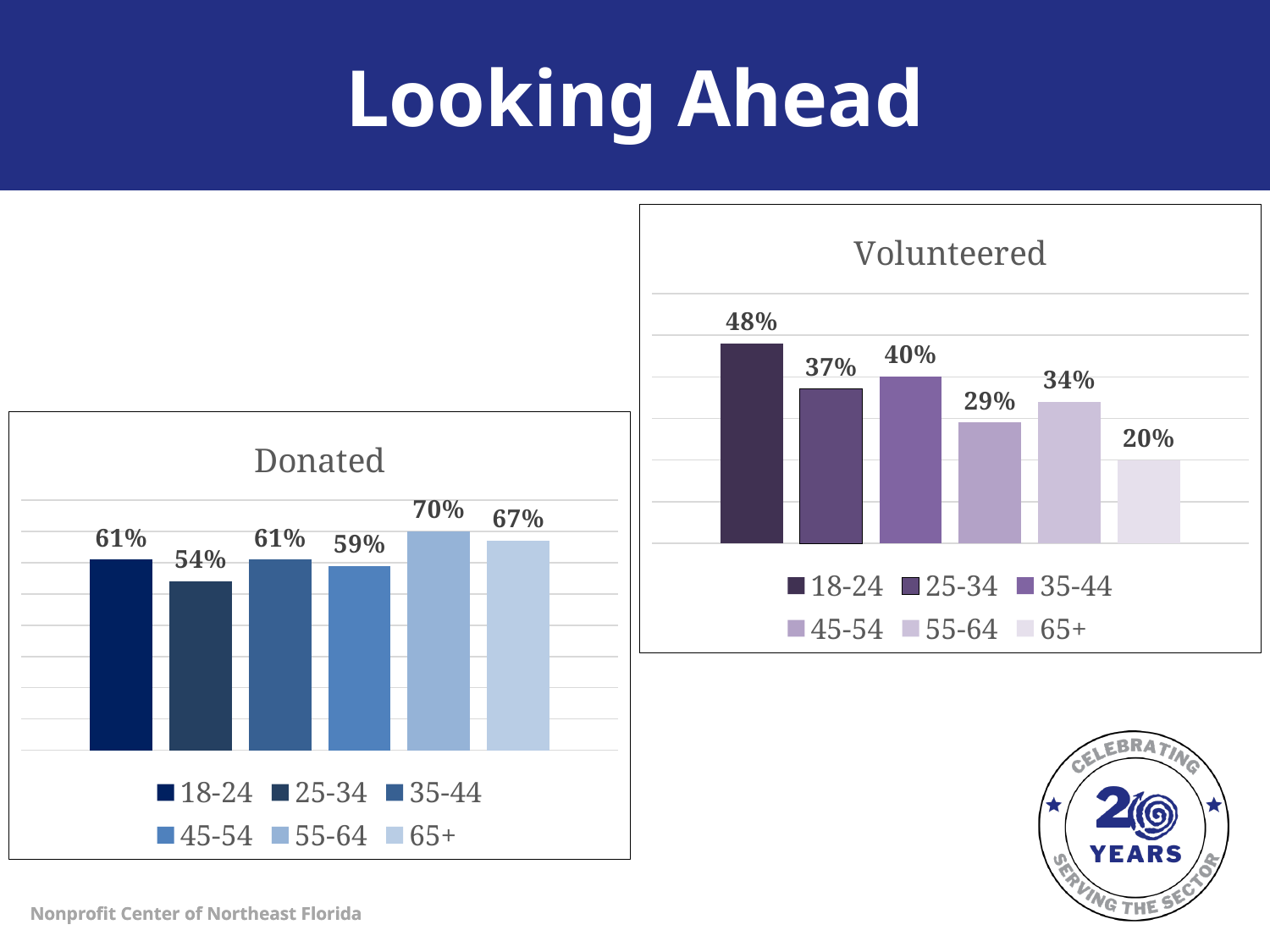
In the Volunteered chart, what is the difference between the 18-24 and 65+ values? 28% What is the title of the chart on the left side of the slide? Donated In the Donated chart, what is the difference between the 55-64 and 25-34 values? 16% How many age groups are shown in the Donated chart? 6 In the Donated chart, what is the value for the 55-64 age group? 70% In the Volunteered chart, what is the value for the 18-24 age group? 48% In the Donated chart, which age group has the lowest value? 25-34 In the Volunteered chart, which is larger, the value for 25-34 or the value for 35-44? 35-44 What kind of chart is the Volunteered chart? Bar chart How many entries does the legend of the Volunteered chart list? 6 In the Volunteered chart, what is the value for the 65+ age group? 20% In the Volunteered chart, which age group has the highest value? 18-24